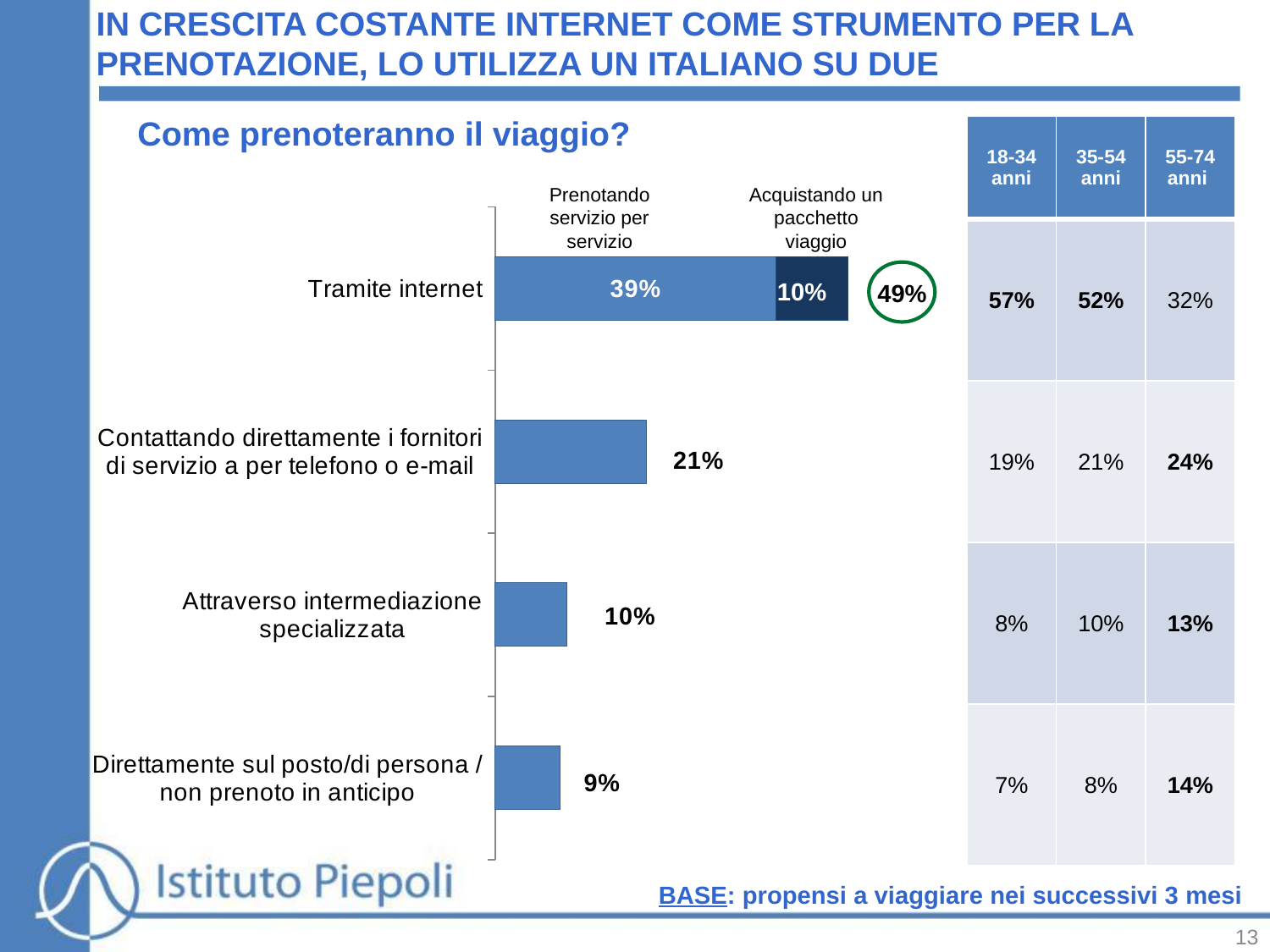
What is the value for 'Direttamente sul posto/di persona / non prenoto in anticipo'? 9% What is the total value shown for 'Tramite internet'? 49% Which booking method has the lowest value? Direttamente sul posto/di persona / non prenoto in anticipo What is the value of the 'Acquistando un pacchetto viaggio' segment for 'Tramite internet'? 10% How many booking method categories are shown in the chart? 4 Which is larger: the value for 'Attraverso intermediazione specializzata' or the value for 'Contattando direttamente i fornitori di servizio a per telefono o e-mail'? Contattando direttamente i fornitori di servizio a per telefono o e-mail What is the difference between the total for 'Tramite internet' and the value for 'Contattando direttamente i fornitori di servizio a per telefono o e-mail'? 28% What type of chart is shown on the slide? Bar chart What is the value for 'Attraverso intermediazione specializzata'? 10% What is the value of the 'Prenotando servizio per servizio' segment for 'Tramite internet'? 39% What is the value for 'Contattando direttamente i fornitori di servizio a per telefono o e-mail'? 21% Which booking method has the highest total value? Tramite internet